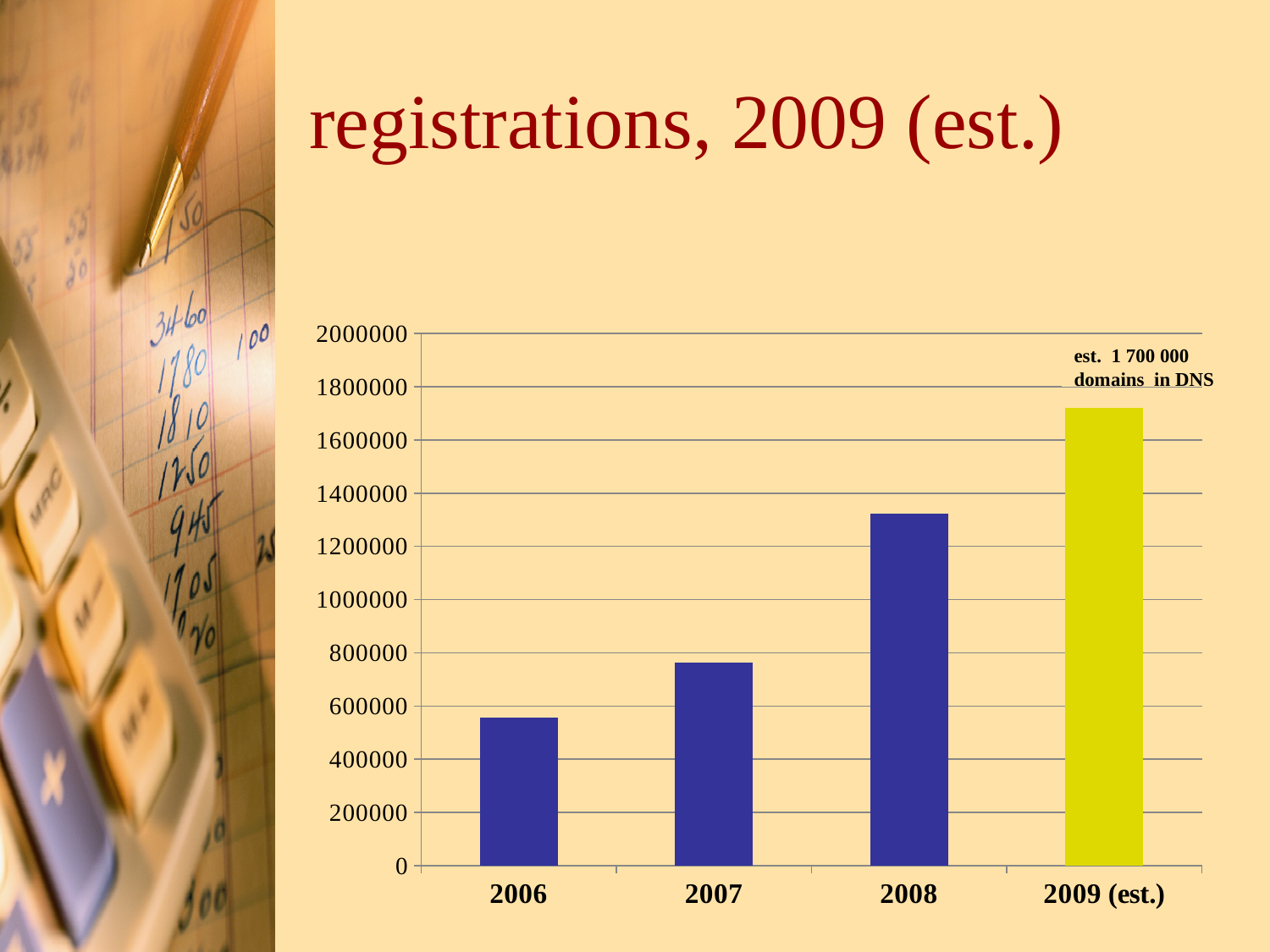
Is the value for 2006 greater or less than 600000? less Do the values rise or fall from 2006 to 2009 (est.) along the x axis? rise Is the value for 2008 greater or less than 1200000? greater Is the value for 2009 (est.) greater or less than 1600000? greater Which category has the lowest bar in the chart? 2006 What kind of chart is shown on the slide? bar chart Which category has the highest bar in the chart? 2009 (est.) How many categories are shown on the x axis of the chart? 4 What does the annotation next to the 2009 (est.) bar say? est. 1 700 000 domains in DNS Which is larger, the value for 2007 or the value for 2008? 2008